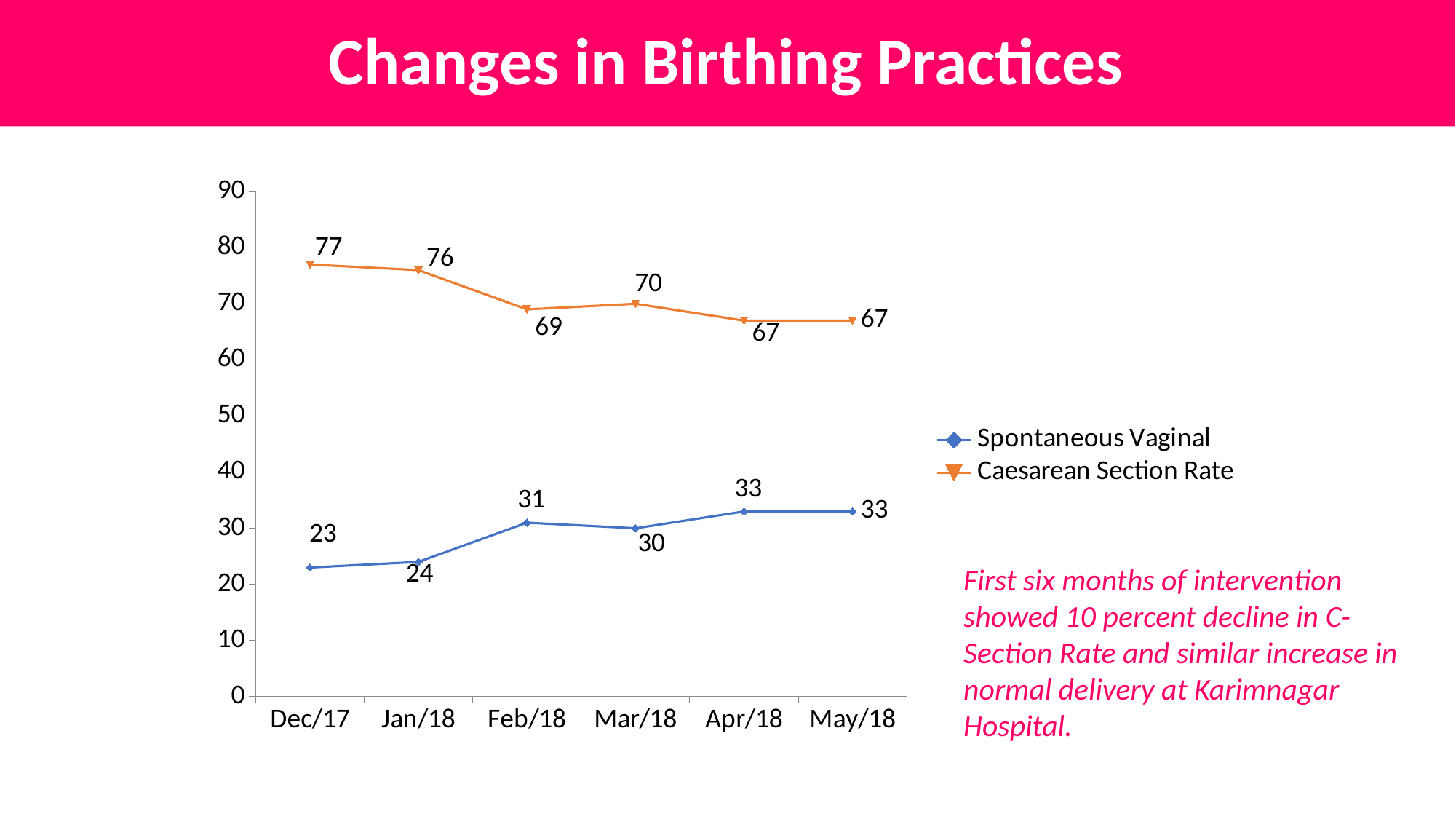
What kind of chart is shown on the slide? Line chart How many months are shown on the x axis? 6 What is the difference between the Caesarean Section Rate in Dec/17 and May/18? 10 What is the Caesarean Section Rate value for Dec/17? 77 Which is larger in Apr/18: the Caesarean Section Rate or the Spontaneous Vaginal value? Caesarean Section Rate How many series does the legend list? 2 What is the Caesarean Section Rate value for Feb/18? 69 What is the Spontaneous Vaginal value for Mar/18? 30 Does the Caesarean Section Rate generally rise or fall from Dec/17 to May/18? Fall What is the difference between the Spontaneous Vaginal values for Feb/18 and Jan/18? 7 In which month is the Caesarean Section Rate highest? Dec/17 In which month is the Spontaneous Vaginal value lowest? Dec/17